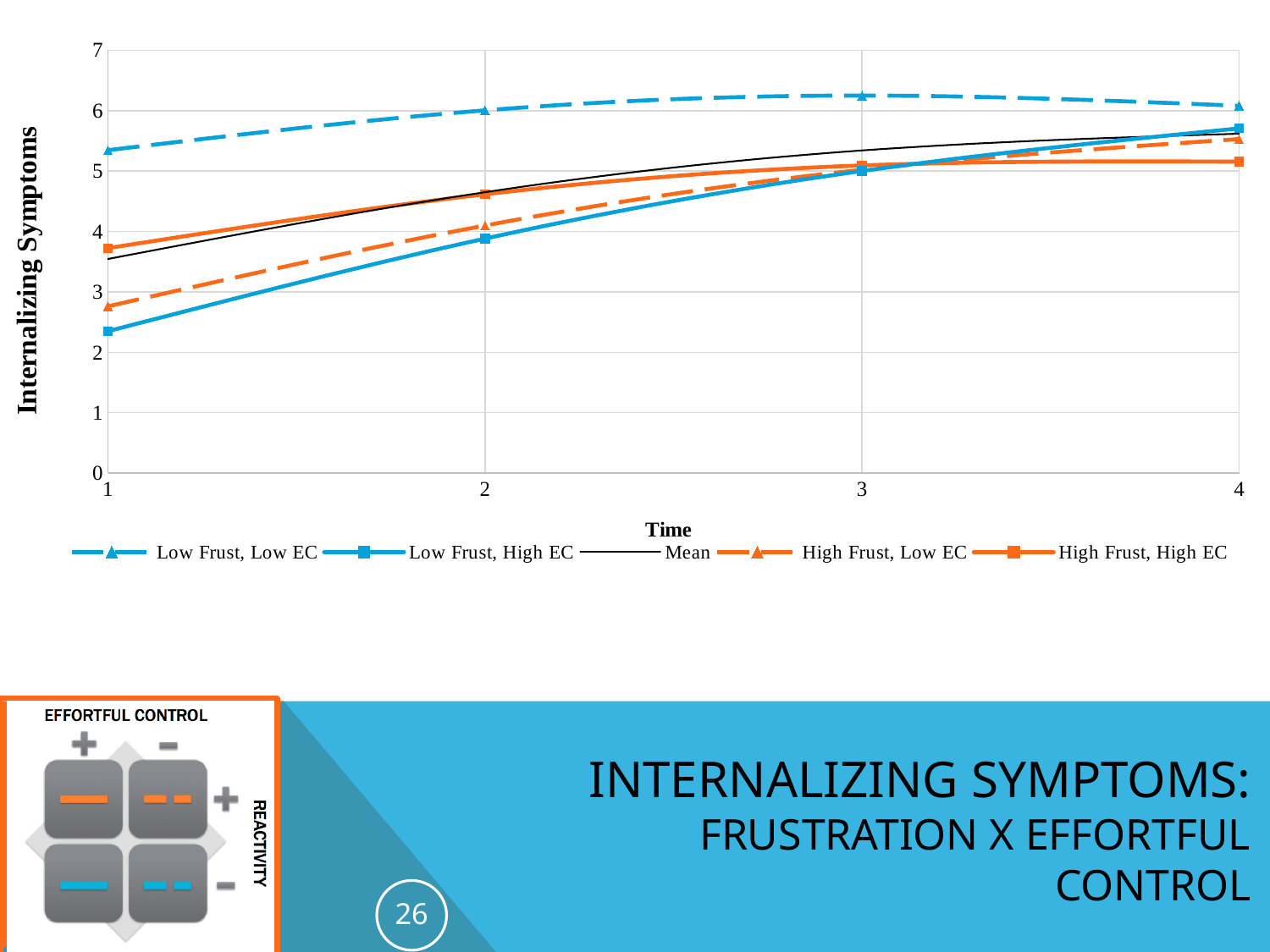
At Time 1, which is larger: High Frust, High EC or High Frust, Low EC? High Frust, High EC How many series does the legend list? 5 Is the value for Low Frust, Low EC at Time 3 greater or less than 6? greater Is the value for Low Frust, High EC at Time 1 greater or less than 3? less What kind of chart is shown on the slide? line chart Which series has the lowest value at Time 1? Low Frust, High EC How many time points are plotted along the x axis? 4 Which series has the highest value at Time 1? Low Frust, Low EC What is the title of the y axis? Internalizing Symptoms Which series has the lowest value at Time 4? High Frust, High EC Is the value for Low Frust, Low EC at Time 1 greater or less than 5? greater Does the Low Frust, High EC series rise or fall from Time 1 to Time 4? rises